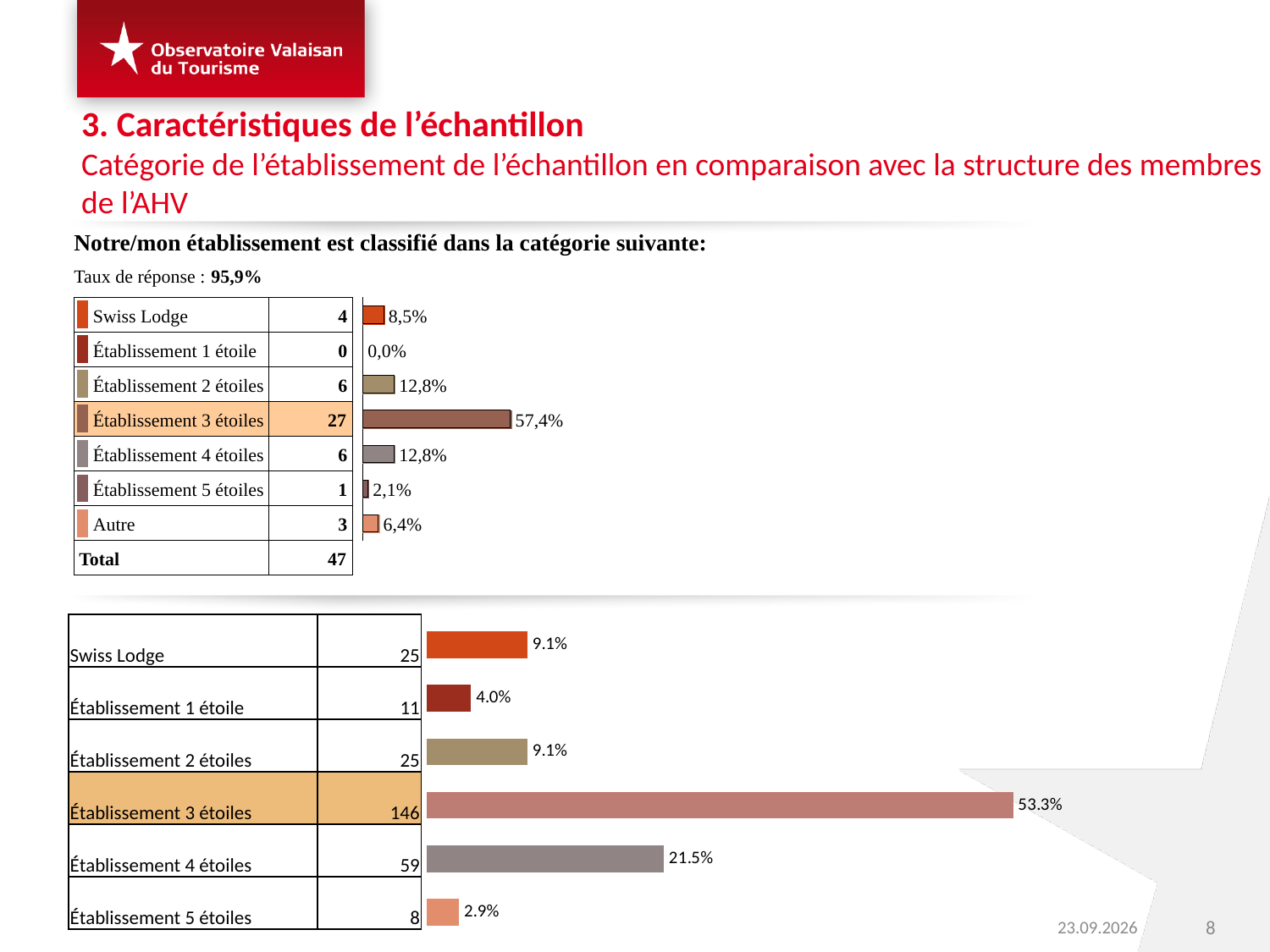
In the bottom chart, what percentage is shown for Établissement 1 étoile? 4.0% In the top chart, which is larger: the percentage for Autre or for Établissement 5 étoiles? Autre What type of chart is the bottom chart? Bar chart In the top chart, what percentage is shown for Établissement 3 étoiles? 57,4% How many categories are plotted in the top chart? 7 In the top chart, which category has the lowest percentage? Établissement 1 étoile How many categories are plotted in the bottom chart? 6 In the top chart, which category has the highest percentage? Établissement 3 étoiles In the bottom chart, which category has the lowest percentage? Établissement 5 étoiles In the bottom chart, what percentage is shown for Établissement 4 étoiles? 21.5% In the top chart, what percentage is shown for Swiss Lodge? 8,5% In the bottom chart, what is the difference in percentage points between Établissement 3 étoiles and Établissement 4 étoiles? 31.8